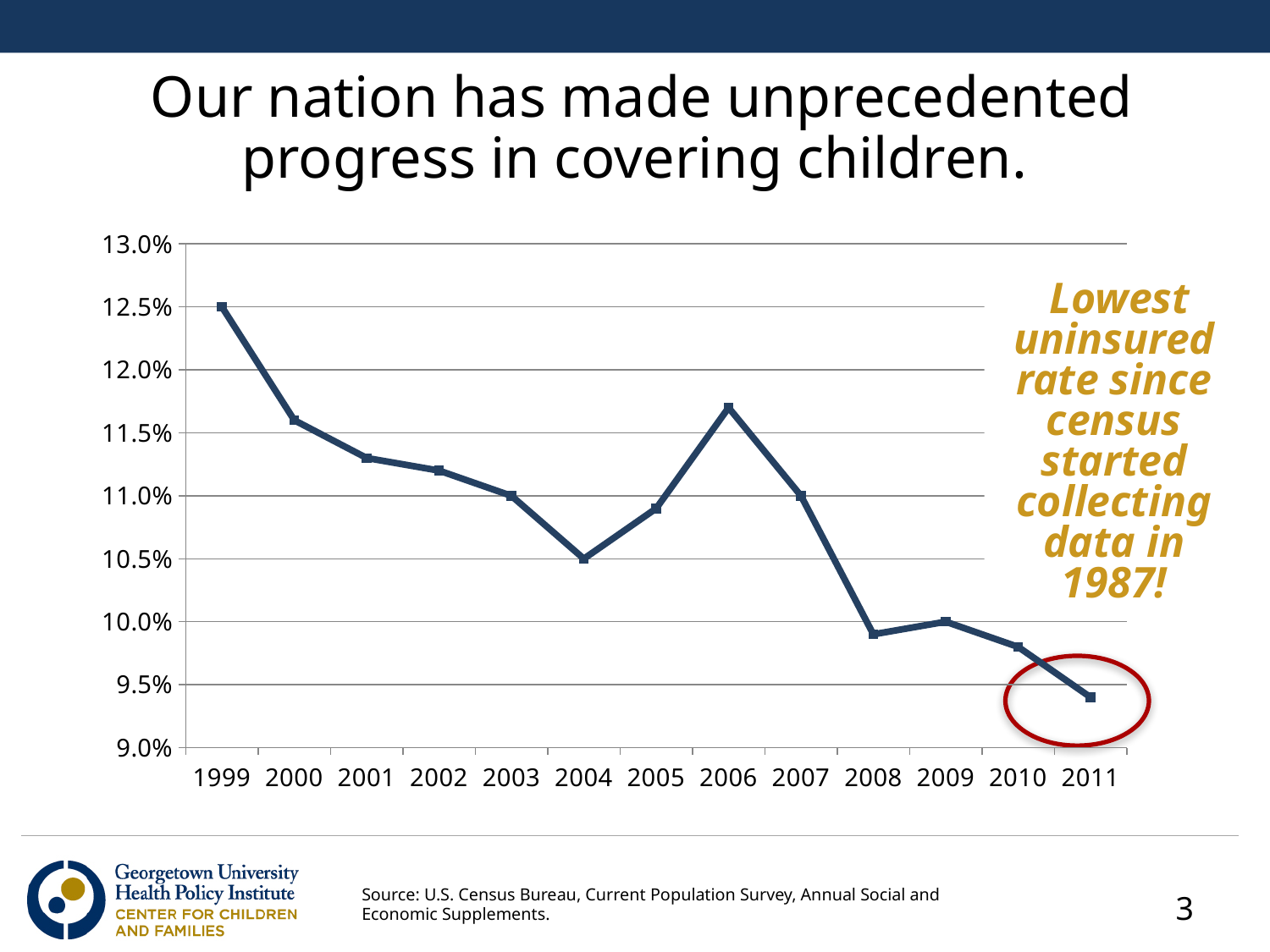
What is the uninsured rate for 2004? 10.5% Which year has the highest uninsured rate on the chart? 1999 Overall, does the uninsured rate rise or fall from 1999 to 2011? Fall Which year has the lowest uninsured rate on the chart? 2011 Is the value for 2011 greater or less than 9.5%? less What is the uninsured rate for 2009? 10.0% How many years are plotted on the x axis of the chart? 13 What is the uninsured rate for 1999? 12.5% What kind of chart is shown on the slide? Line chart Which year has the larger uninsured rate, 2005 or 2006? 2006 According to the annotation on the chart, since what year has the census been collecting this data? 1987 Is the value for 2006 greater or less than 11.5%? greater